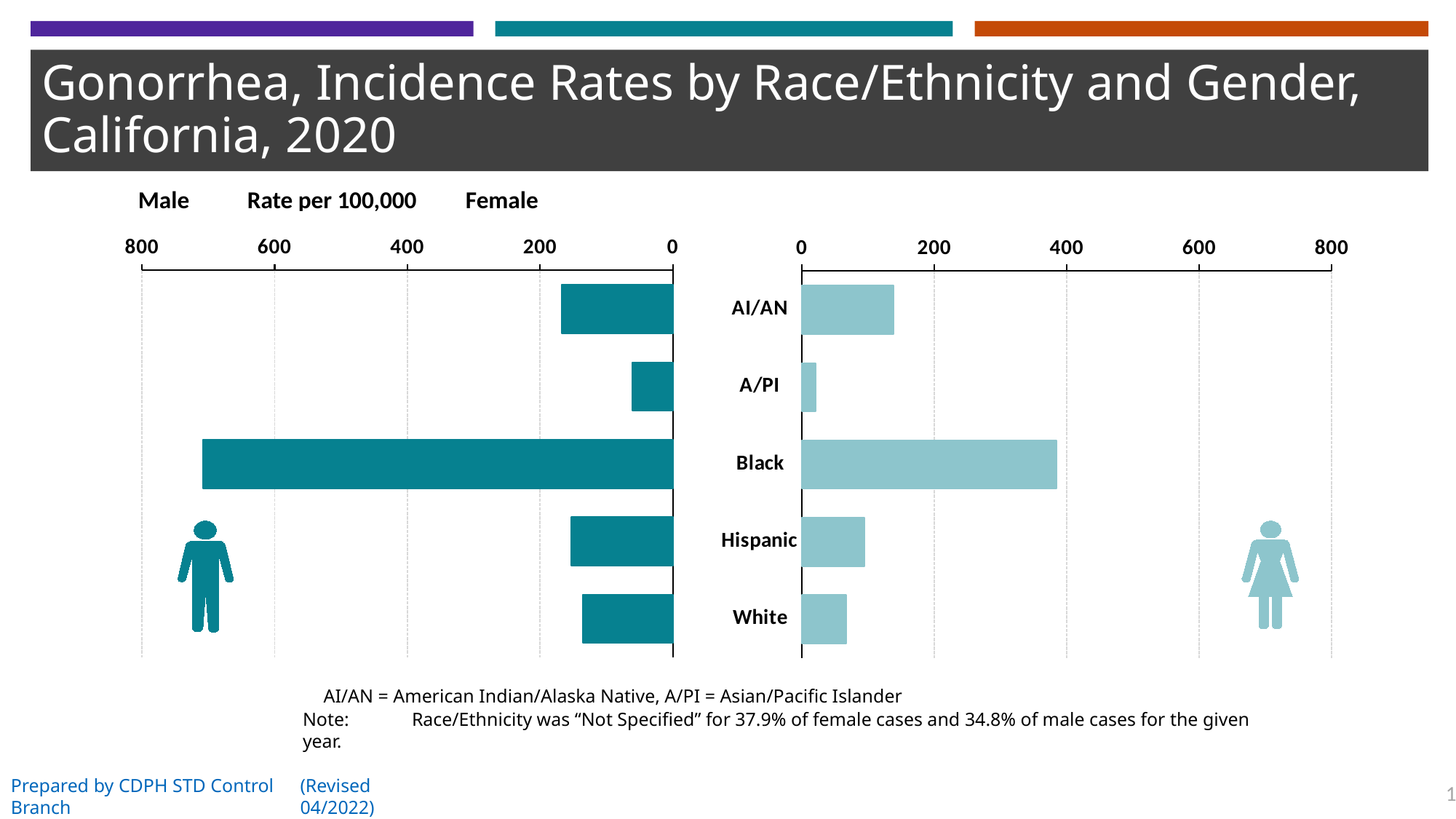
How many race/ethnicity categories are shown on the chart? 5 Is the male rate for A/PI greater or less than 200? less Which race/ethnicity has the highest female gonorrhea incidence rate? Black Is the male rate for Black greater or less than 600? greater Is the female rate for Black greater or less than 400? less Which race/ethnicity has the lowest male gonorrhea incidence rate? A/PI What kind of chart is shown on the slide? bar chart Which is larger, the female rate for AI/AN or the female rate for White? female rate for AI/AN Which is larger, the male rate for Black or the female rate for Black? male rate for Black Which race/ethnicity has the highest male gonorrhea incidence rate? Black Which race/ethnicity has the lowest female gonorrhea incidence rate? A/PI What unit is the rate measured in, according to the chart heading? Rate per 100,000